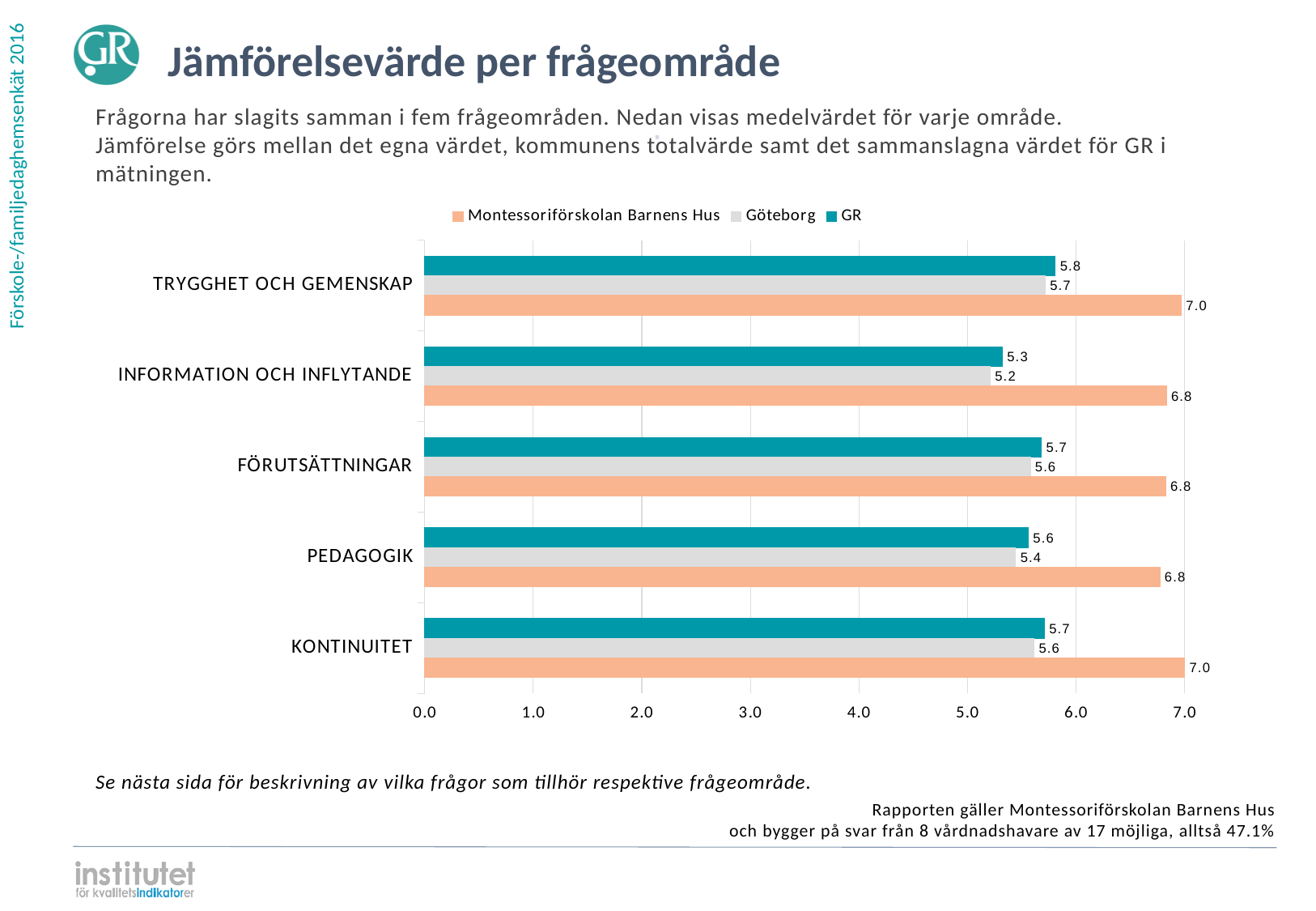
What is the value for Montessoriförskolan Barnens Hus in the TRYGGHET OCH GEMENSKAP category? 7.0 What is the value for GR in the PEDAGOGIK category? 5.6 Which category has the highest value for GR? TRYGGHET OCH GEMENSKAP What is the difference between the Montessoriförskolan Barnens Hus value and the Göteborg value in the INFORMATION OCH INFLYTANDE category? 1.6 How many categories are shown on the chart? 5 What is the value for Göteborg in the INFORMATION OCH INFLYTANDE category? 5.2 Is the value for Montessoriförskolan Barnens Hus in the PEDAGOGIK category greater or less than 6.0? greater How many series does the legend list? 3 What is the value for Göteborg in the KONTINUITET category? 5.6 Which category has the lowest value for Göteborg? INFORMATION OCH INFLYTANDE Which is larger in the FÖRUTSÄTTNINGAR category: the GR value or the Göteborg value? GR What kind of chart is shown on the slide? Bar chart